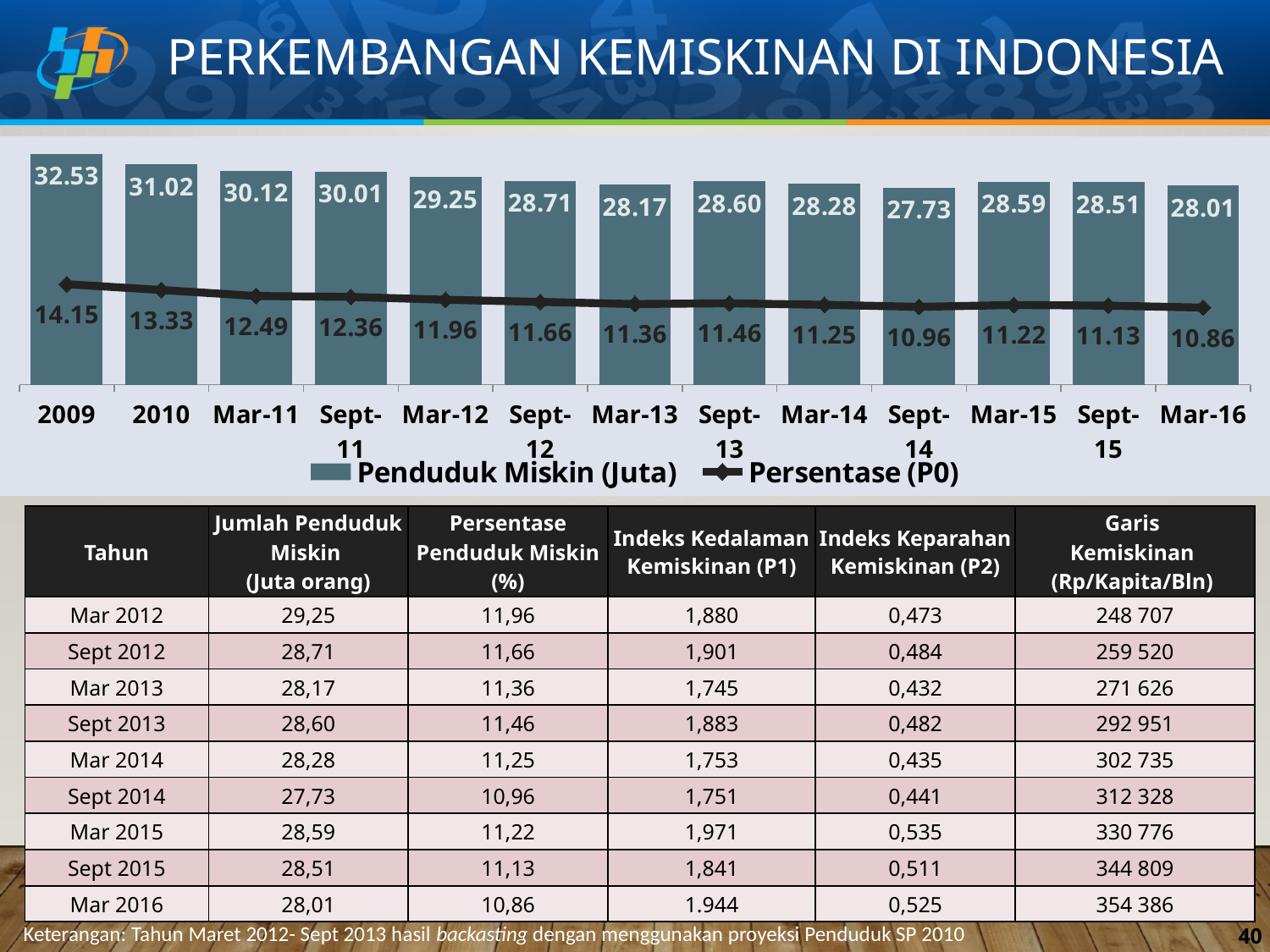
What are the two series named in the legend? Penduduk Miskin (Juta) and Persentase (P0) What is the Persentase (P0) value for Mar-16? 10.86 What is the difference in Penduduk Miskin (Juta) between 2009 and 2010? 1.51 What kind of chart is this? Combined bar and line chart Which is larger, the Penduduk Miskin (Juta) value for Sept-13 or for Mar-13? Sept-13 What is the value of Penduduk Miskin (Juta) for 2009? 32.53 Which category has the highest Penduduk Miskin (Juta) value? 2009 Which category has the lowest Persentase (P0) value? Mar-16 How many series does the legend list? 2 What is the Penduduk Miskin (Juta) value for Sept-14? 27.73 Does the Persentase (P0) line generally rise or fall from 2009 to Mar-16? Fall How many categories are shown on the x axis? 13